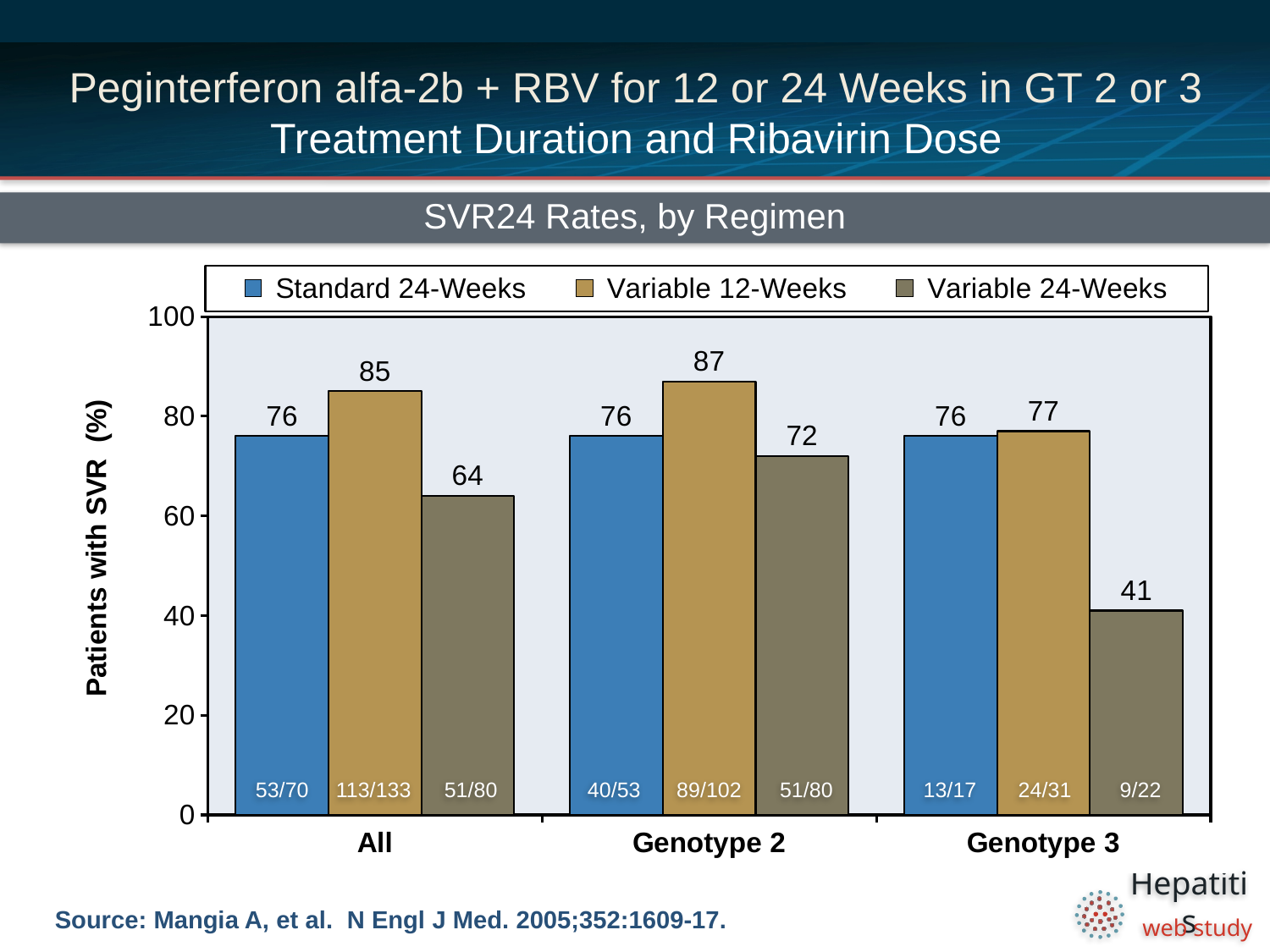
Which is larger in Genotype 2: the Variable 24-Weeks SVR rate or the Standard 24-Weeks SVR rate? Standard 24-Weeks How many genotype groups are shown on the x axis? 3 How many series does the legend list? 3 What is the SVR rate for Variable 12-Weeks in the All group? 85 What is the SVR rate for Standard 24-Weeks in Genotype 2? 76 Which regimen has the lowest SVR rate in Genotype 3? Variable 24-Weeks What is the difference between the Standard 24-Weeks and Variable 24-Weeks SVR rates in Genotype 3? 35 Which regimen has the highest SVR rate in Genotype 2? Variable 12-Weeks What is the label of the y axis? Patients with SVR (%) What is the difference between the Variable 12-Weeks and Variable 24-Weeks SVR rates in the All group? 21 What is the SVR rate for Variable 24-Weeks in Genotype 3? 41 What kind of chart is shown on the slide? Bar chart